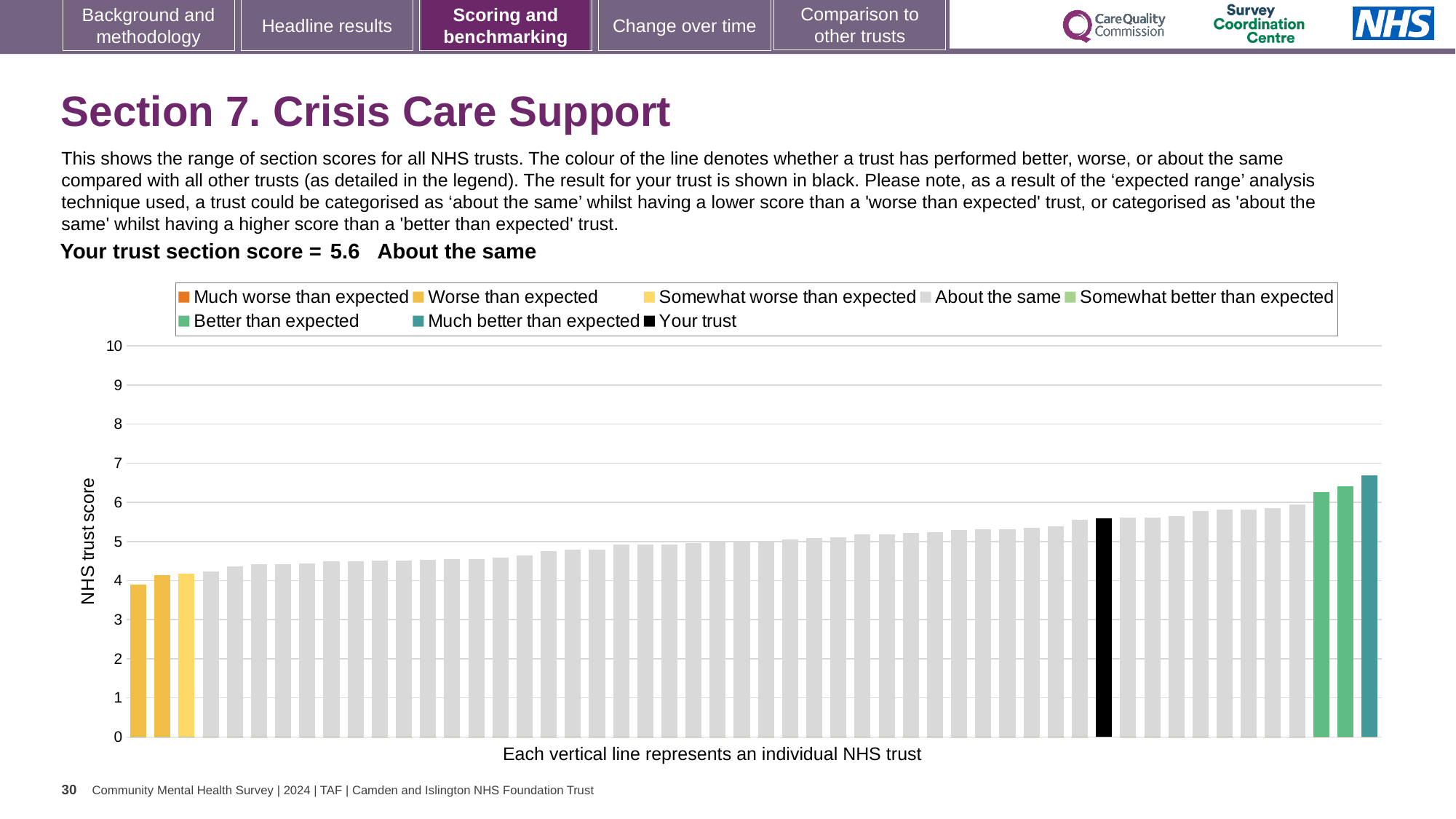
How many bars are coloured teal for 'Much better than expected'? 1 What is the label on the y axis of the chart? NHS trust score Do the bar values rise or fall from left to right along the x axis? rise How many entries does the chart legend list? 8 Is the value of the highest bar greater or less than 6? greater Is the value of the lowest bar greater or less than 5? less What kind of chart is shown on the slide? bar chart How is your trust's section score categorised compared with other trusts? About the same What is the highest value shown on the y axis? 10 What is the section score for your trust shown on the slide? 5.6 Is the value for your trust greater or less than 5? greater